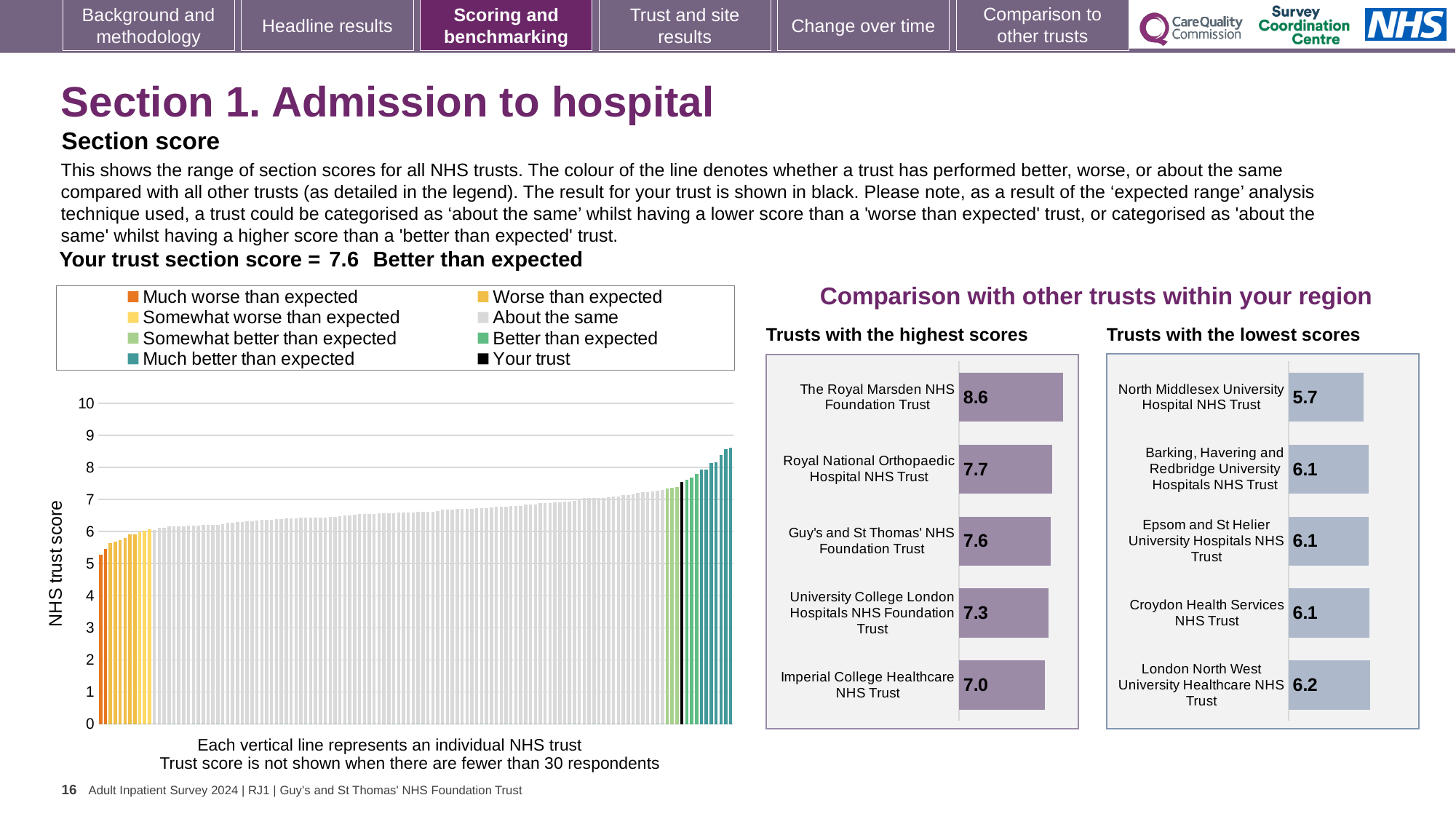
How many entries does the legend of the large chart on the left list? 8 In the 'Trusts with the highest scores' chart, what is the difference between the scores of The Royal Marsden NHS Foundation Trust and Imperial College Healthcare NHS Trust? 1.6 In the 'Trusts with the highest scores' chart, which has the higher score: Royal National Orthopaedic Hospital NHS Trust or University College London Hospitals NHS Foundation Trust? Royal National Orthopaedic Hospital NHS Trust What kind of chart is the large chart on the left showing the range of NHS trust scores? bar chart In the 'Trusts with the lowest scores' chart, what is the score for London North West University Healthcare NHS Trust? 6.2 In the large chart on the left, is the value for the black 'Your trust' bar greater or less than 7? greater How many trusts are shown in the 'Trusts with the highest scores' chart? 5 In the 'Trusts with the lowest scores' chart, which trust has the lowest score? North Middlesex University Hospital NHS Trust In the 'Trusts with the highest scores' chart, what is the score for The Royal Marsden NHS Foundation Trust? 8.6 In the 'Trusts with the highest scores' chart, which trust has the highest score? The Royal Marsden NHS Foundation Trust In the 'Trusts with the lowest scores' chart, what is the difference between the scores of London North West University Healthcare NHS Trust and North Middlesex University Hospital NHS Trust? 0.5 In the 'Trusts with the lowest scores' chart, what is the score for North Middlesex University Hospital NHS Trust? 5.7